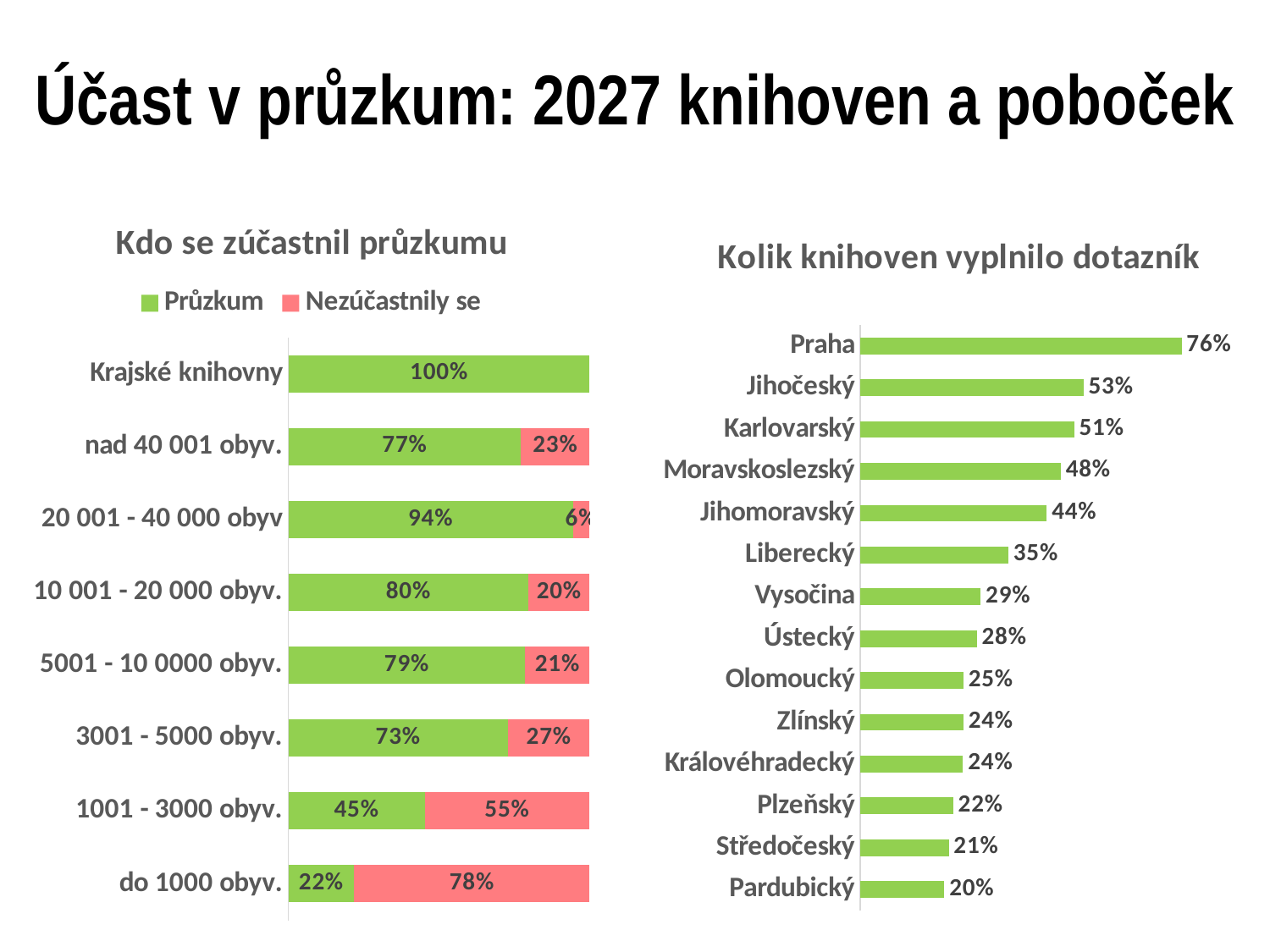
In the chart 'Kolik knihoven vyplnilo dotazník', what is the difference between the values for Praha and Jihočeský? 23% In the chart 'Kolik knihoven vyplnilo dotazník', what is the value for Liberecký? 35% In the chart 'Kdo se zúčastnil průzkumu', how many categories are shown? 8 In the chart 'Kdo se zúčastnil průzkumu', which category has the highest Nezúčastnily se value? do 1000 obyv. In the chart 'Kdo se zúčastnil průzkumu', what is the Průzkum value for 'do 1000 obyv.'? 22% In the chart 'Kolik knihoven vyplnilo dotazník', how many regions are shown? 14 In the chart 'Kdo se zúčastnil průzkumu', what is the Nezúčastnily se value for '1001 - 3000 obyv.'? 55% In the chart 'Kolik knihoven vyplnilo dotazník', which region has the highest value? Praha What type of chart is 'Kolik knihoven vyplnilo dotazník'? bar chart In the chart 'Kdo se zúčastnil průzkumu', what is the difference between the Průzkum values for 'nad 40 001 obyv.' and '3001 - 5000 obyv.'? 4% In the chart 'Kdo se zúčastnil průzkumu', how many series does the legend list? 2 In the chart 'Kolik knihoven vyplnilo dotazník', which region has the lowest value? Pardubický